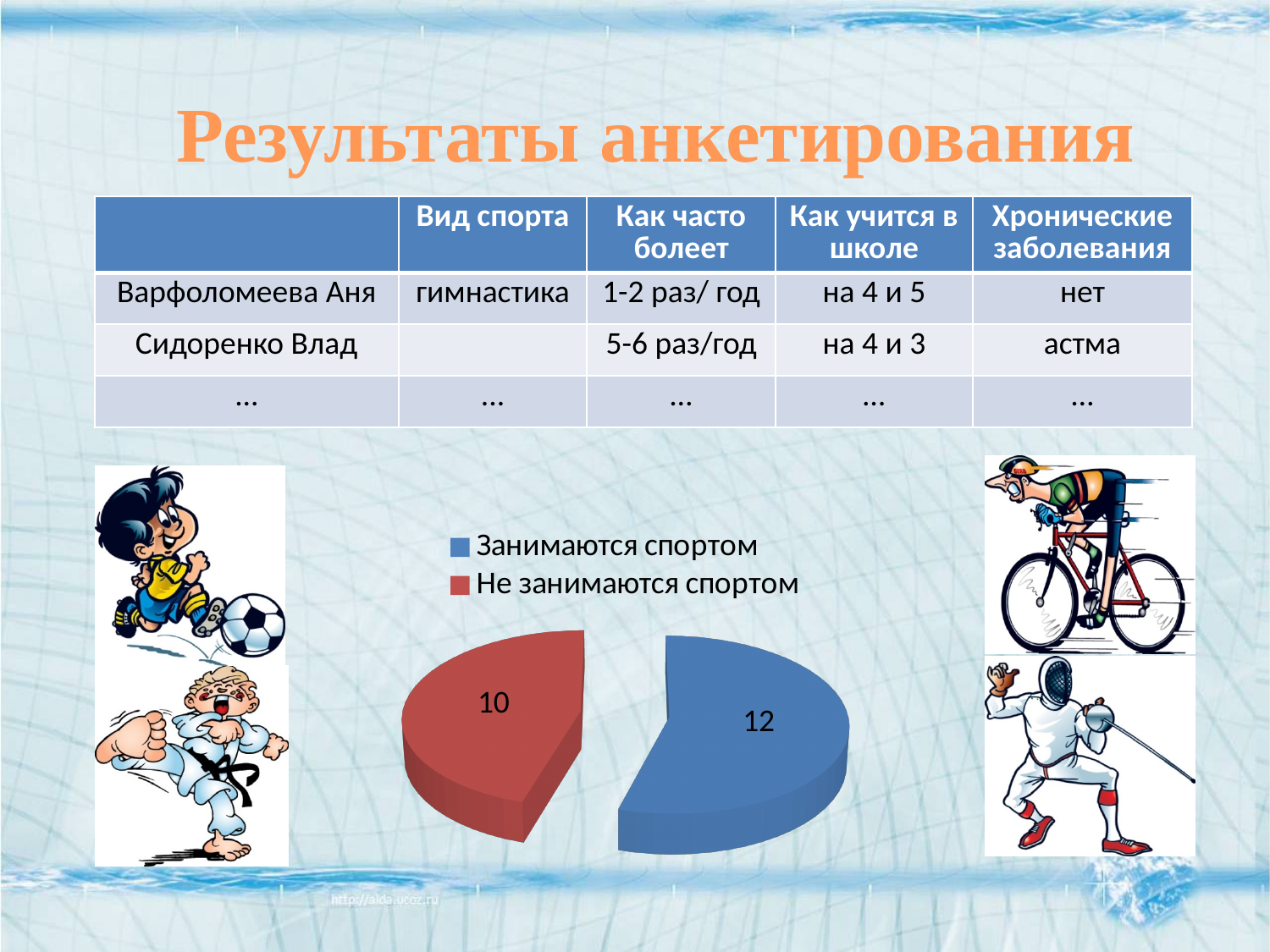
Which is larger in the pie chart: "Занимаются спортом" or "Не занимаются спортом"? Занимаются спортом What value is shown for the "Не занимаются спортом" slice of the pie chart? 10 What colour is the "Не занимаются спортом" slice in the pie chart? red What type of chart is shown on the slide? pie chart What is the title of the slide containing the pie chart? Результаты анкетирования What is the difference between the "Занимаются спортом" and "Не занимаются спортом" values in the pie chart? 2 Which category has the smallest slice in the pie chart? Не занимаются спортом What is the total of all slices in the pie chart? 22 What value is shown for the "Занимаются спортом" slice of the pie chart? 12 Which category has the largest slice in the pie chart? Занимаются спортом How many entries does the pie chart's legend list? 2 How many slices does the pie chart have? 2